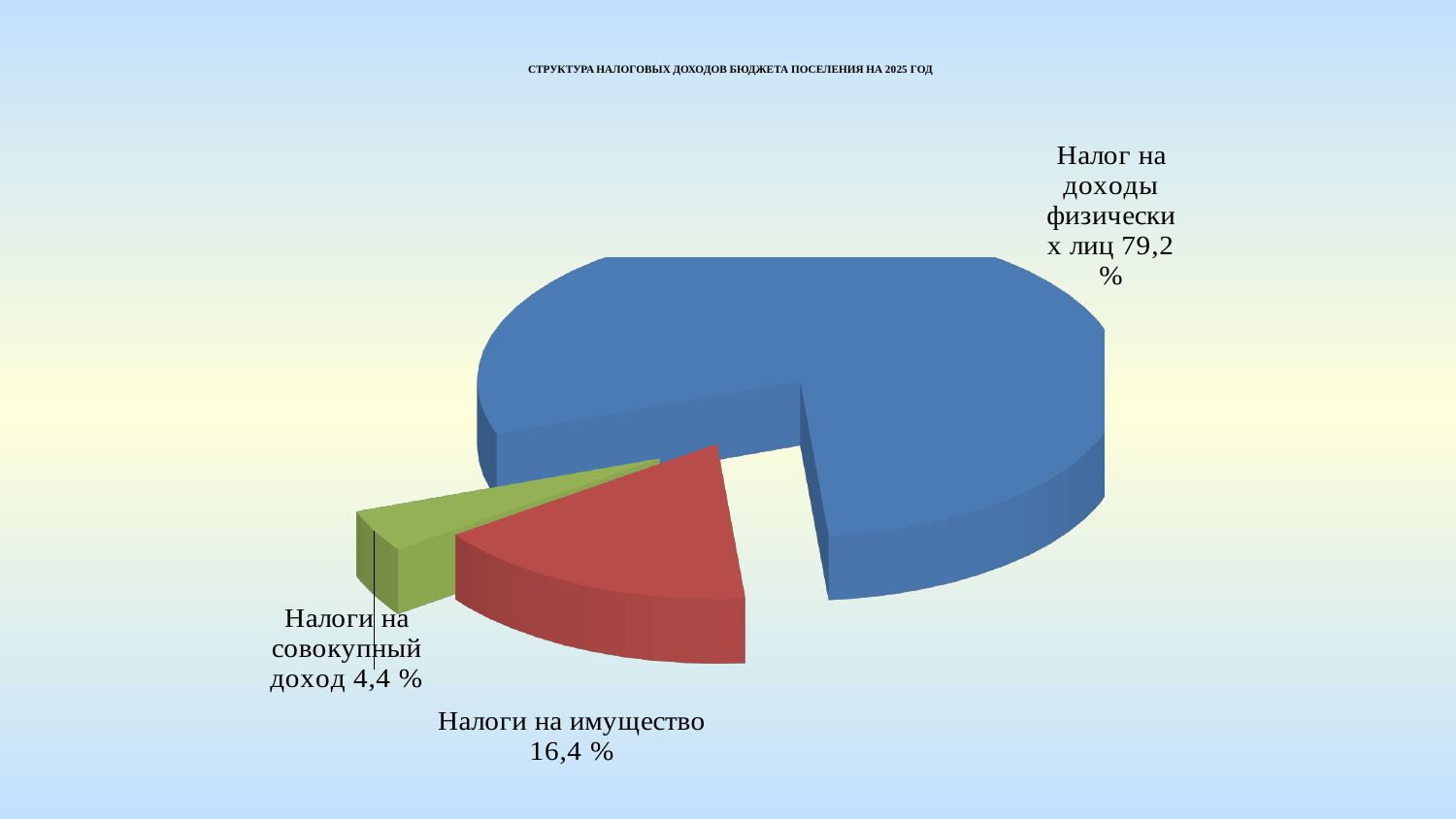
Which category has the largest slice of the pie? Налог на доходы физических лиц What is the difference in percentage points between Налог на доходы физических лиц and Налоги на имущество? 62,8 Which is larger: Налоги на имущество or Налоги на совокупный доход? Налоги на имущество What share of the pie does Налоги на совокупный доход have? 4,4 % What is the difference in percentage points between Налоги на имущество and Налоги на совокупный доход? 12,0 What is the title of the chart? СТРУКТУРА НАЛОГОВЫХ ДОХОДОВ БЮДЖЕТА ПОСЕЛЕНИЯ НА 2025 ГОД What share of the pie does Налог на доходы физических лиц have? 79,2 % What share of the pie does Налоги на имущество have? 16,4 % What colour is the slice for Налоги на имущество? Red What kind of chart is shown on the slide? Pie chart How many slices does the pie chart have? 3 Which category has the smallest slice of the pie? Налоги на совокупный доход